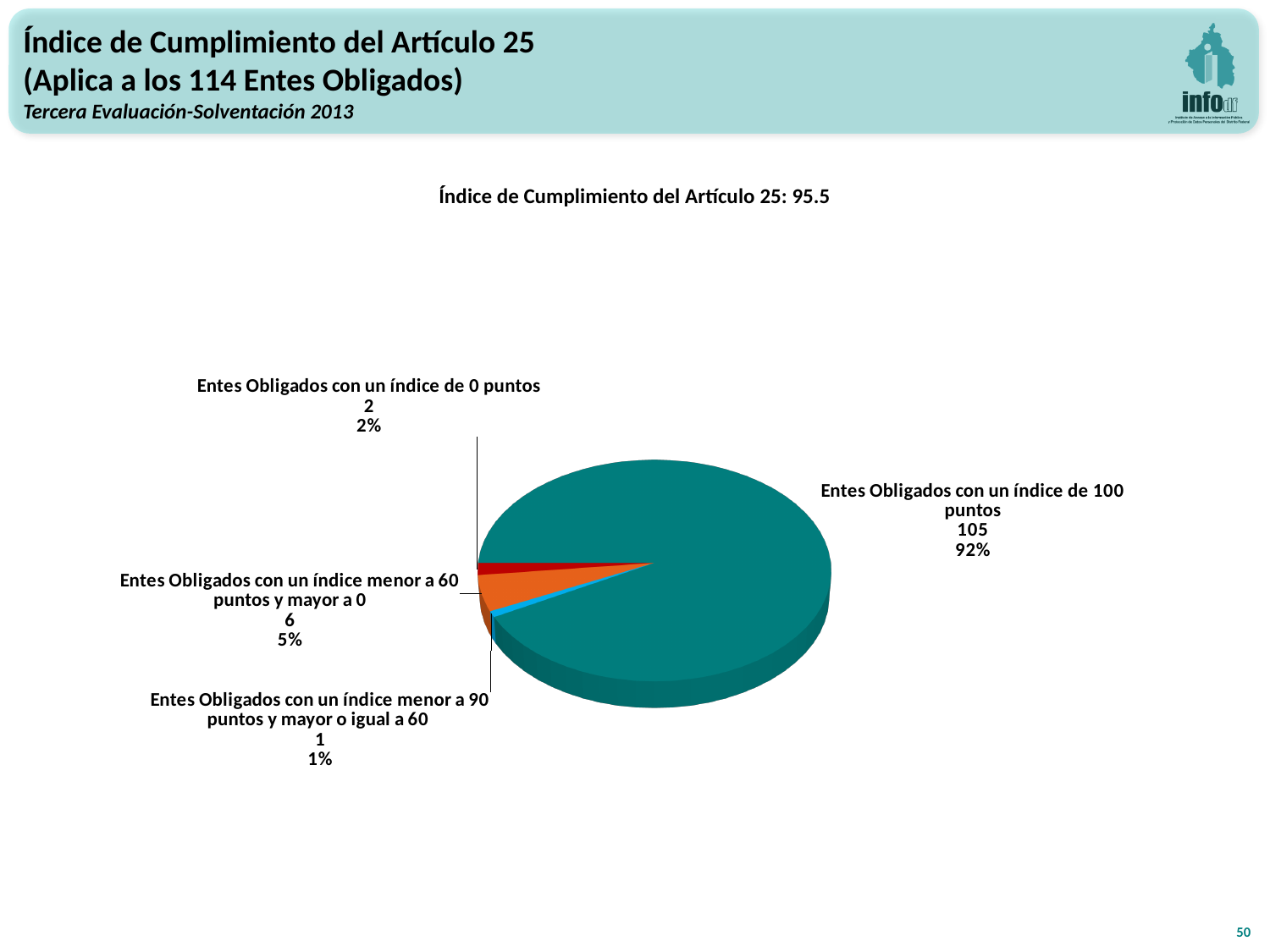
What is the difference between the number of Entes Obligados with an index of 100 points and those with an index lower than 60 and greater than 0? 99 Which category has the smallest slice of the pie? Entes Obligados con un índice menor a 90 puntos y mayor o igual a 60 Which category has the largest slice of the pie? Entes Obligados con un índice de 100 puntos How many Entes Obligados have an index lower than 90 points and greater than or equal to 60? 1 Which is larger: the number of Entes Obligados with an index of 0 points or those with an index lower than 60 and greater than 0? Entes Obligados con un índice menor a 60 puntos y mayor a 0 What share of the pie is 'Entes Obligados con un índice menor a 60 puntos y mayor a 0'? 5% What kind of chart is shown on the slide? Pie chart How many Entes Obligados have an index of 100 points? 105 What percentage of the pie corresponds to Entes Obligados with an index of 100 points? 92% What is the title of the chart? Índice de Cumplimiento del Artículo 25: 95.5 How many Entes Obligados have an index of 0 points? 2 How many categories does the pie chart show? 4